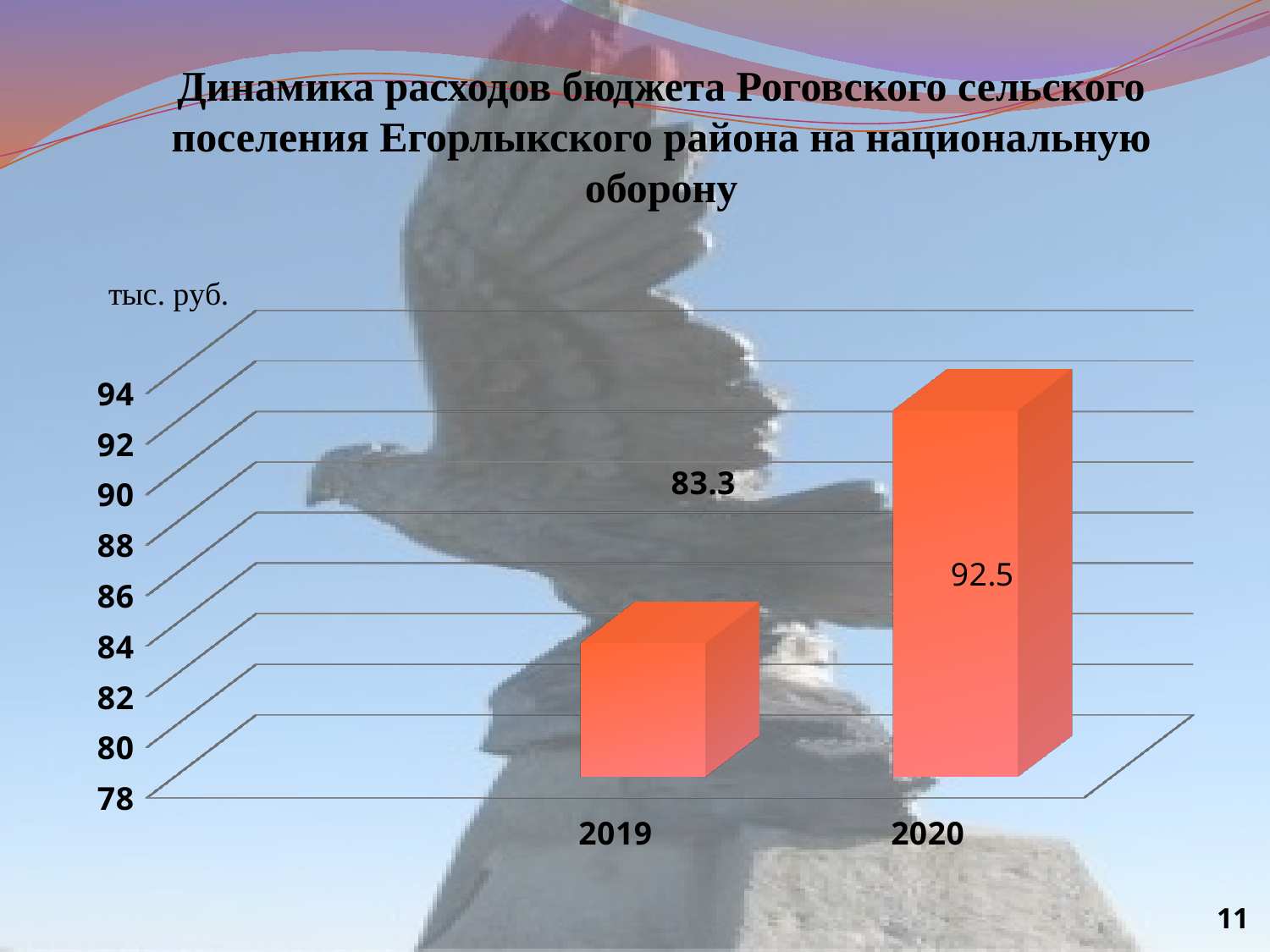
What kind of chart is shown on the slide? Bar chart What is the value for 2019? 83.3 Which year has the lower value? 2019 What is the value for 2020? 92.5 How many years are shown on the chart? 2 Is the value for 2020 greater or less than 90? greater Do the values rise or fall from 2019 to 2020? Rise What is the difference between the values for 2020 and 2019? 9.2 What unit is indicated above the vertical axis of the chart? тыс. руб. Is the value for 2020 larger than the value for 2019? Yes Which year has the higher value? 2020 Is the value for 2019 greater or less than 84? less